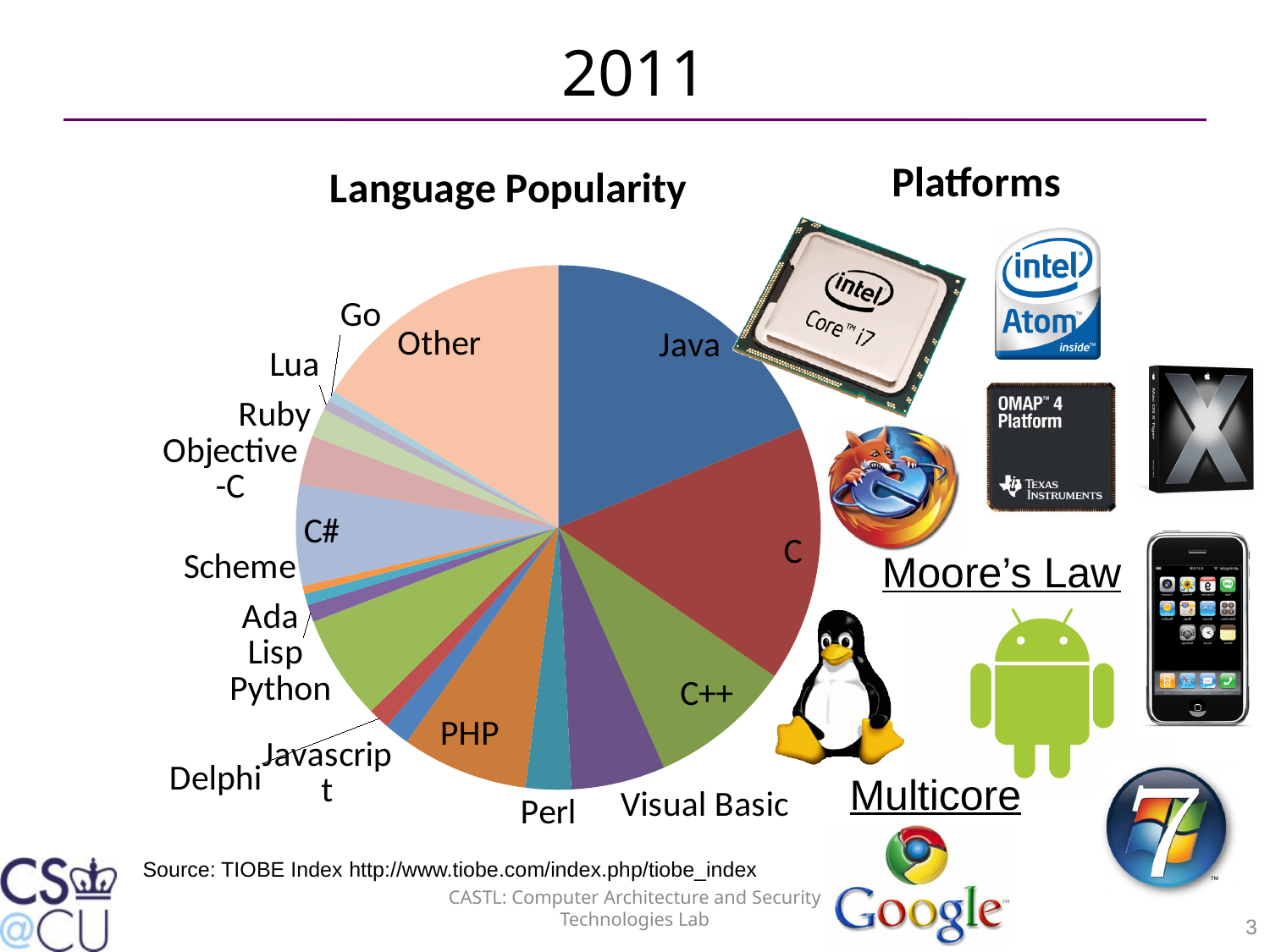
What kind of chart is the Language Popularity chart? pie chart What is the title of the pie chart on the slide? Language Popularity In the Language Popularity pie chart, which slice is larger, C or C++? C In the Language Popularity pie chart, which slice is larger, Java or C++? Java Which language has the largest slice in the Language Popularity pie chart? Java In the Language Popularity pie chart, which slice is larger, C or Perl? C How many language slices does the Language Popularity pie chart have? 18 According to the slide, what is the source of the Language Popularity data? TIOBE Index